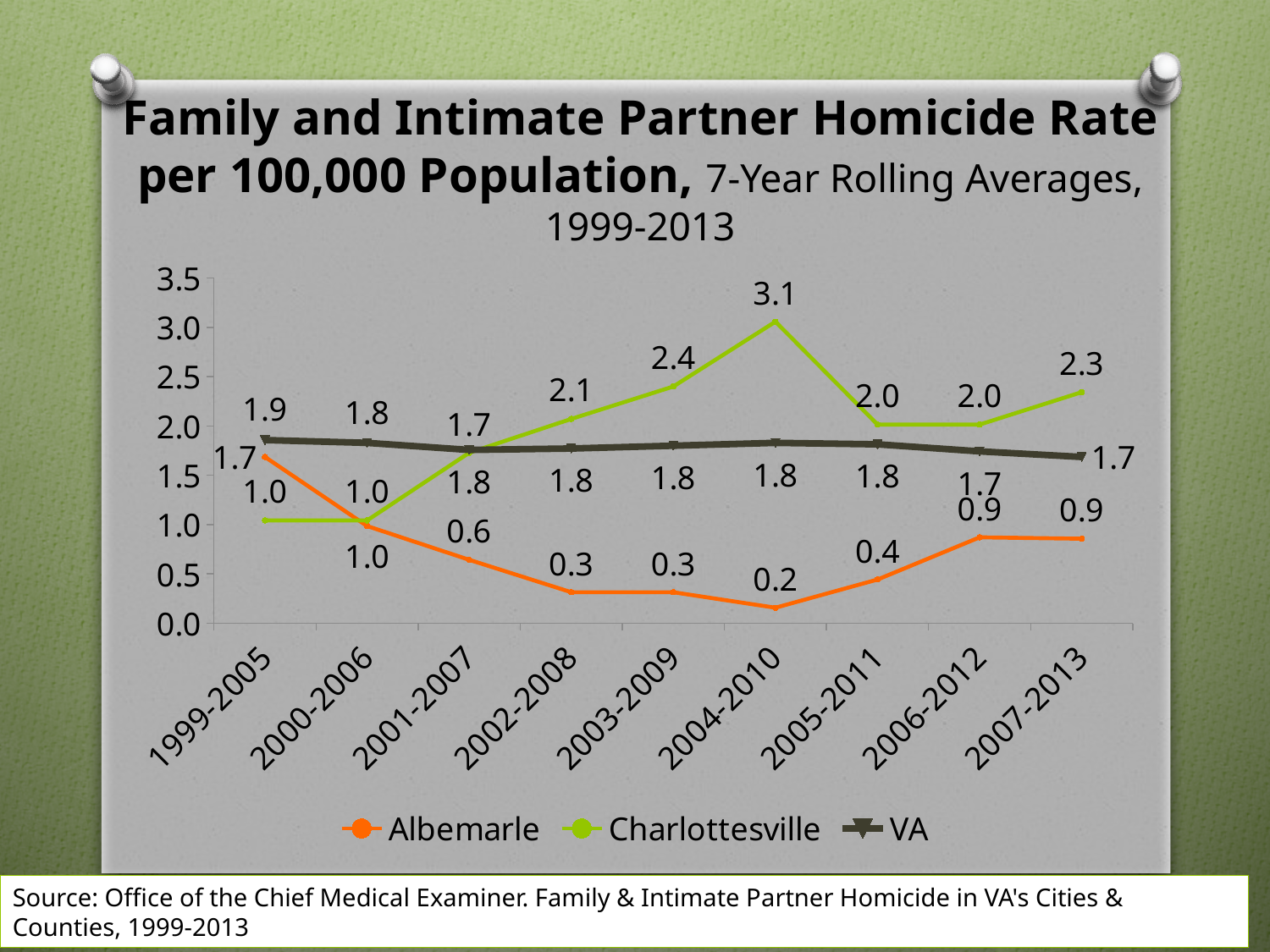
In the 2007-2013 period, which is higher: the Charlottesville rate or the VA rate? Charlottesville What colour is the Albemarle line? Orange In which period is the Albemarle rate lowest? 2004-2010 What is the difference between the Charlottesville and Albemarle rates in the 2004-2010 period? 2.9 What is the Charlottesville homicide rate for the 2004-2010 period? 3.1 In which period does Charlottesville reach its highest rate? 2004-2010 What is the VA rate for the 2007-2013 period? 1.7 How many rolling-average periods are plotted along the x axis? 9 Does the Albemarle rate rise or fall from 1999-2005 to 2004-2010? Fall What kind of chart is shown on the slide? Line chart How many series does the legend list? 3 What is the Albemarle rate for the 2007-2013 period? 0.9